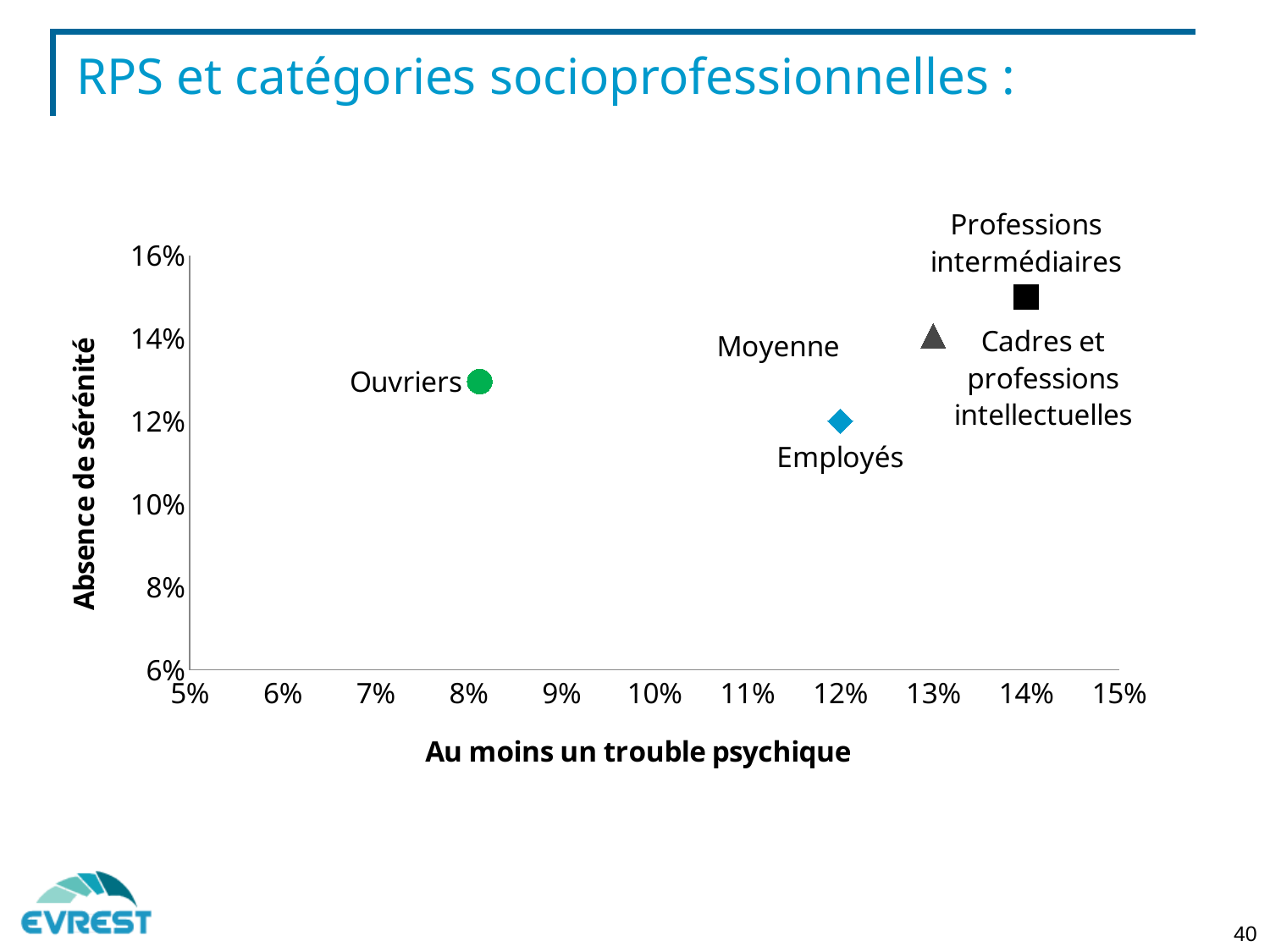
What is the 'Absence de sérénité' value for Employés? 12% What is the 'Au moins un trouble psychique' value for Employés? 12% What type of chart is shown on the slide? scatter chart Which category has the lowest 'Au moins un trouble psychique' value? Ouvriers What is the title of the horizontal axis? Au moins un trouble psychique Which has the higher 'Absence de sérénité' value, Ouvriers or Employés? Ouvriers What is the title of the vertical axis? Absence de sérénité Is the 'Absence de sérénité' value for Ouvriers greater or less than 12%? greater Which category has the lowest 'Absence de sérénité' value? Employés Is the 'Au moins un trouble psychique' value for Ouvriers greater or less than 9%? less Is the 'Au moins un trouble psychique' value for Employés greater or less than 10%? greater